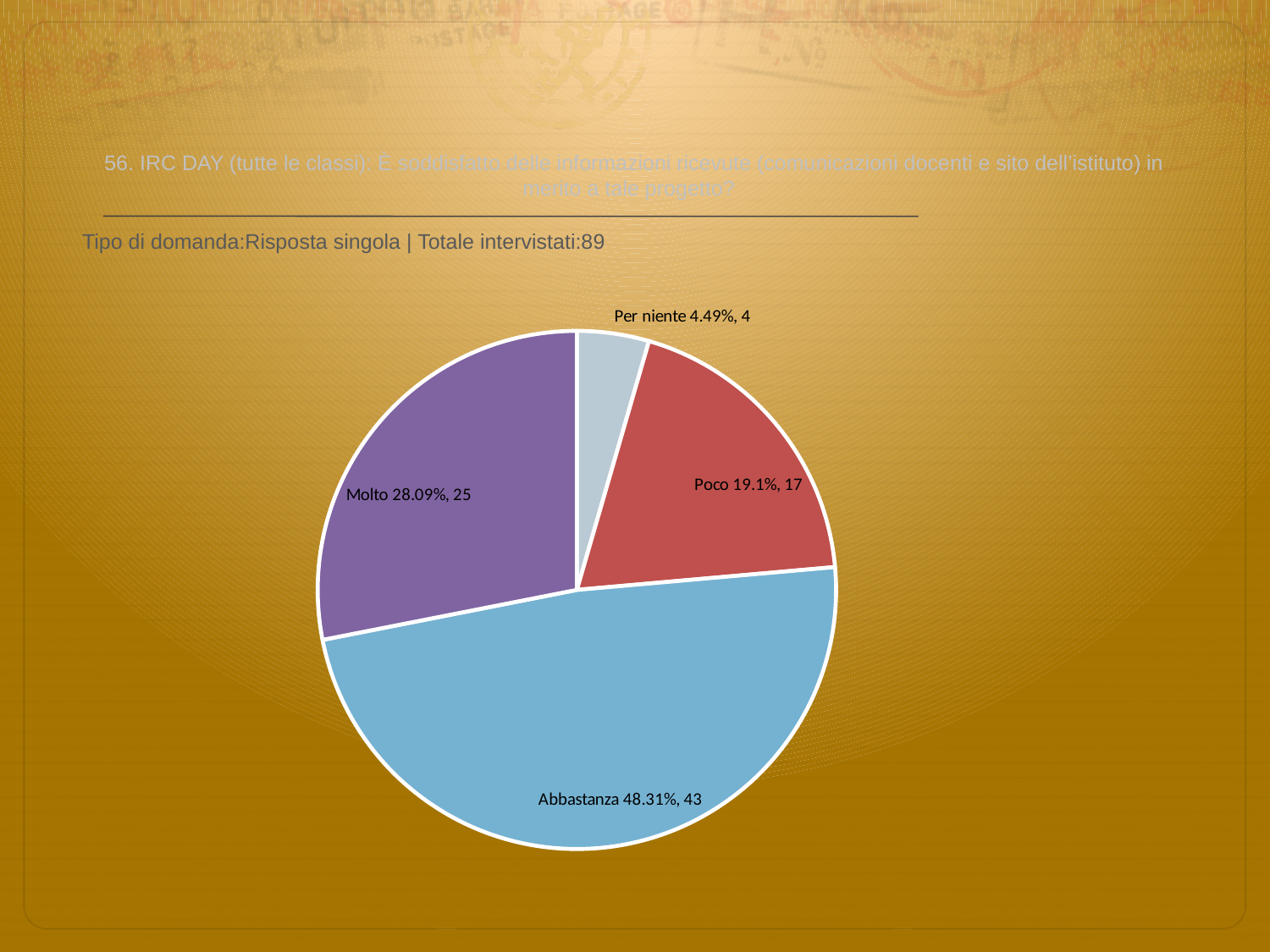
What is the share of the pie for "Molto"? 28.09% What is the total number of respondents (Totale intervistati) stated on the slide? 89 How many respondents answered "Per niente"? 4 Which response has the smallest share of the pie? Per niente Which response has the largest share of the pie? Abbastanza Which response received more respondents, "Poco" or "Molto"? Molto What kind of chart is shown on the slide? pie chart What percentage of respondents answered "Poco"? 19.1% How many respondents answered "Molto"? 25 What percentage of respondents answered "Abbastanza"? 48.31% How many more respondents answered "Abbastanza" than "Molto"? 18 How many slices does the pie chart have? 4